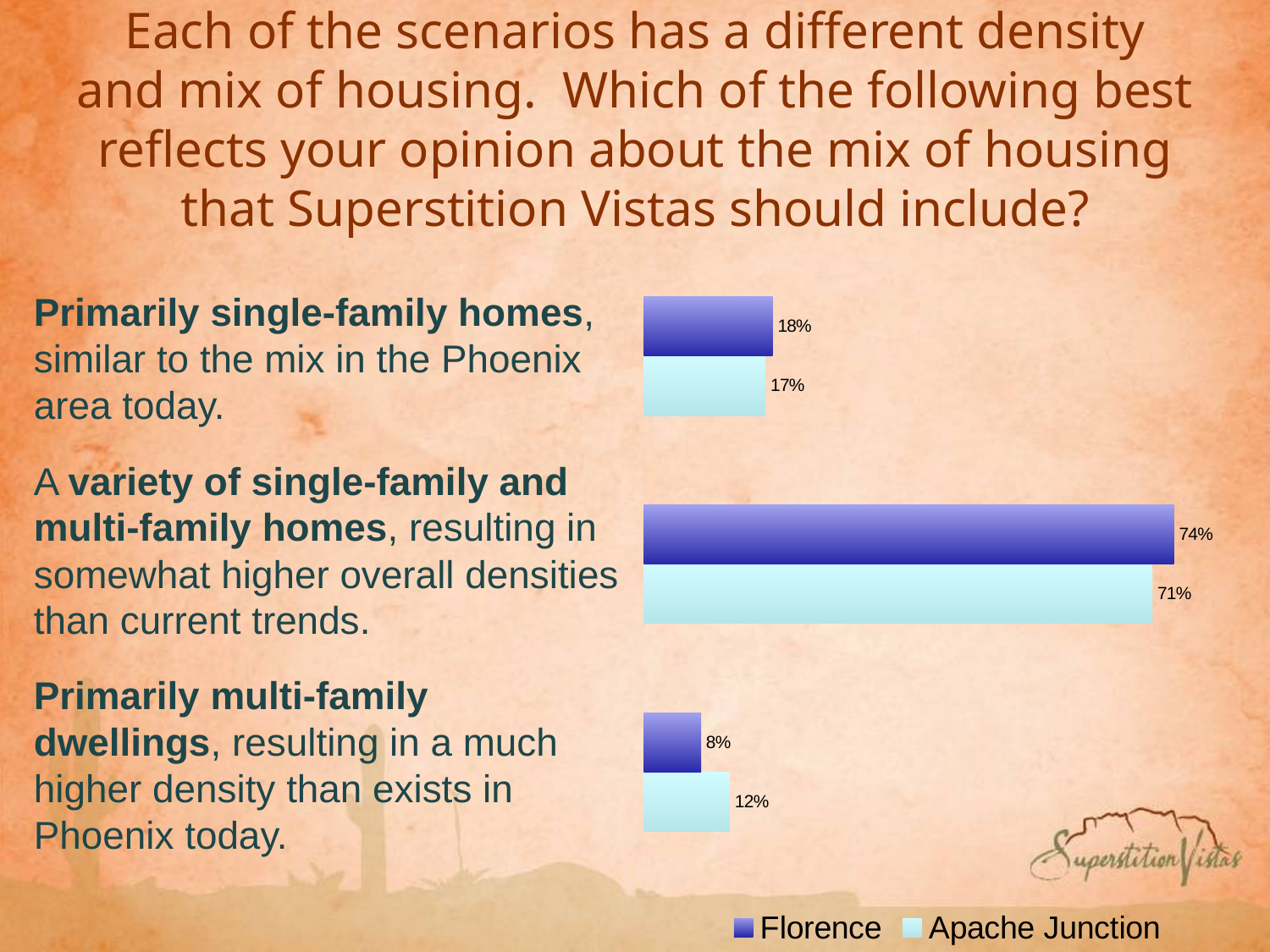
Which housing mix option received the highest share of Florence respondents? A variety of single-family and multi-family homes How many series does the legend list? 2 Which series is shown in dark blue in the legend? Florence What percentage of Florence respondents chose primarily single-family homes? 18% What is the difference between the Apache Junction and Florence percentages for primarily multi-family dwellings? 4% What percentage of Apache Junction respondents chose a variety of single-family and multi-family homes? 71% How many housing mix options are shown in the chart? 3 Which housing mix option received the lowest share of Florence respondents? Primarily multi-family dwellings What is the difference between the Florence and Apache Junction percentages for a variety of single-family and multi-family homes? 3% What kind of chart is shown on the slide? Bar chart For primarily multi-family dwellings, which has the larger percentage: Florence or Apache Junction? Apache Junction What percentage of Apache Junction respondents chose primarily multi-family dwellings? 12%